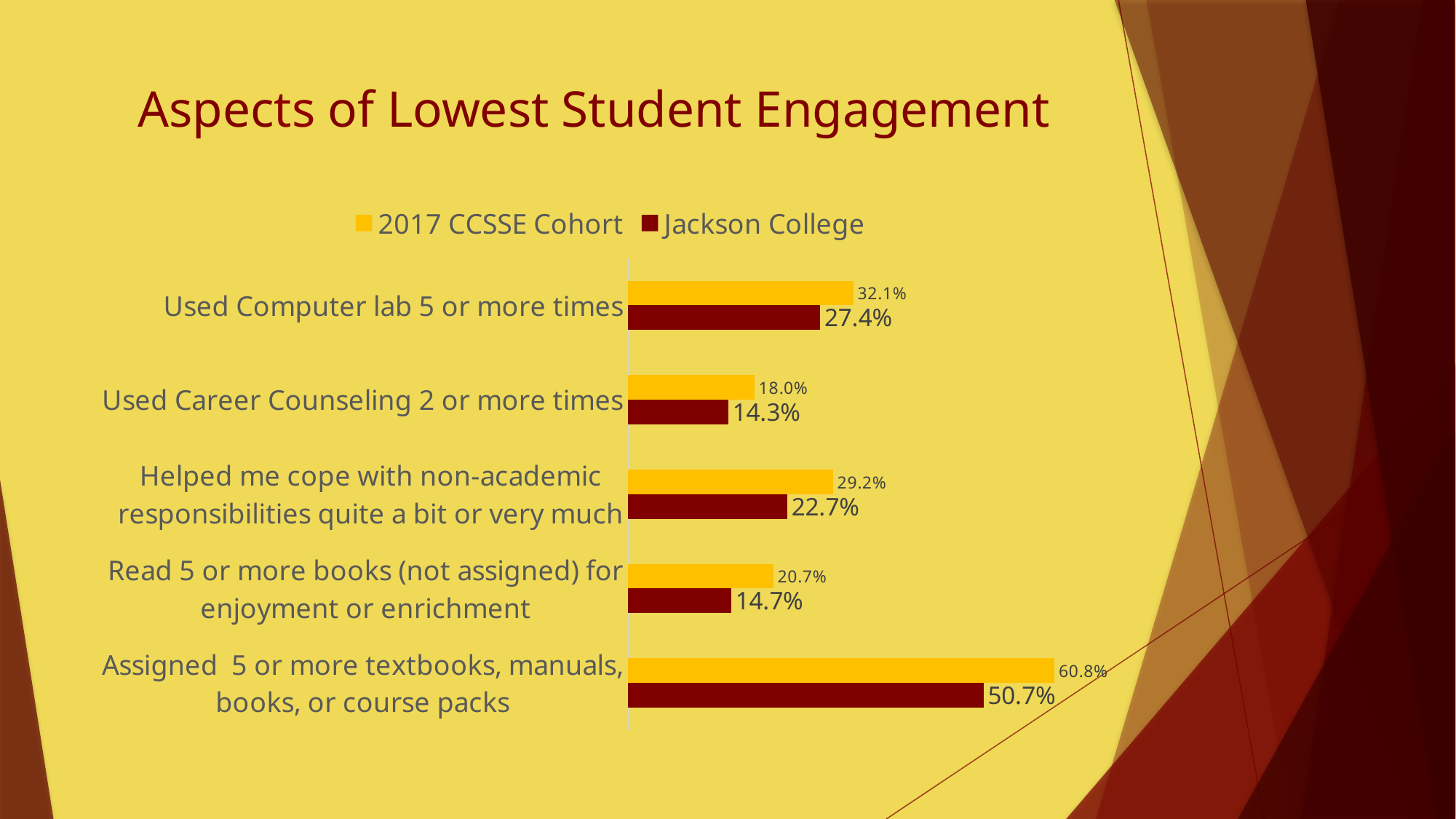
What is the Jackson College value for 'Used Computer lab 5 or more times'? 27.4% Which category has the highest Jackson College value? Assigned 5 or more textbooks, manuals, books, or course packs What is the 2017 CCSSE Cohort value for 'Assigned 5 or more textbooks, manuals, books, or course packs'? 60.8% How many series does the legend list? 2 Which is larger for 'Used Computer lab 5 or more times': the 2017 CCSSE Cohort value or the Jackson College value? 2017 CCSSE Cohort Which category has the lowest Jackson College value? Used Career Counseling 2 or more times What is the 2017 CCSSE Cohort value for 'Used Career Counseling 2 or more times'? 18.0% What is the title of the chart? Aspects of Lowest Student Engagement What is the difference between the 2017 CCSSE Cohort and Jackson College values for 'Helped me cope with non-academic responsibilities quite a bit or very much'? 6.5% What kind of chart is shown on the slide? Bar chart What is the Jackson College value for 'Read 5 or more books (not assigned) for enjoyment or enrichment'? 14.7% How many categories are shown in the chart? 5